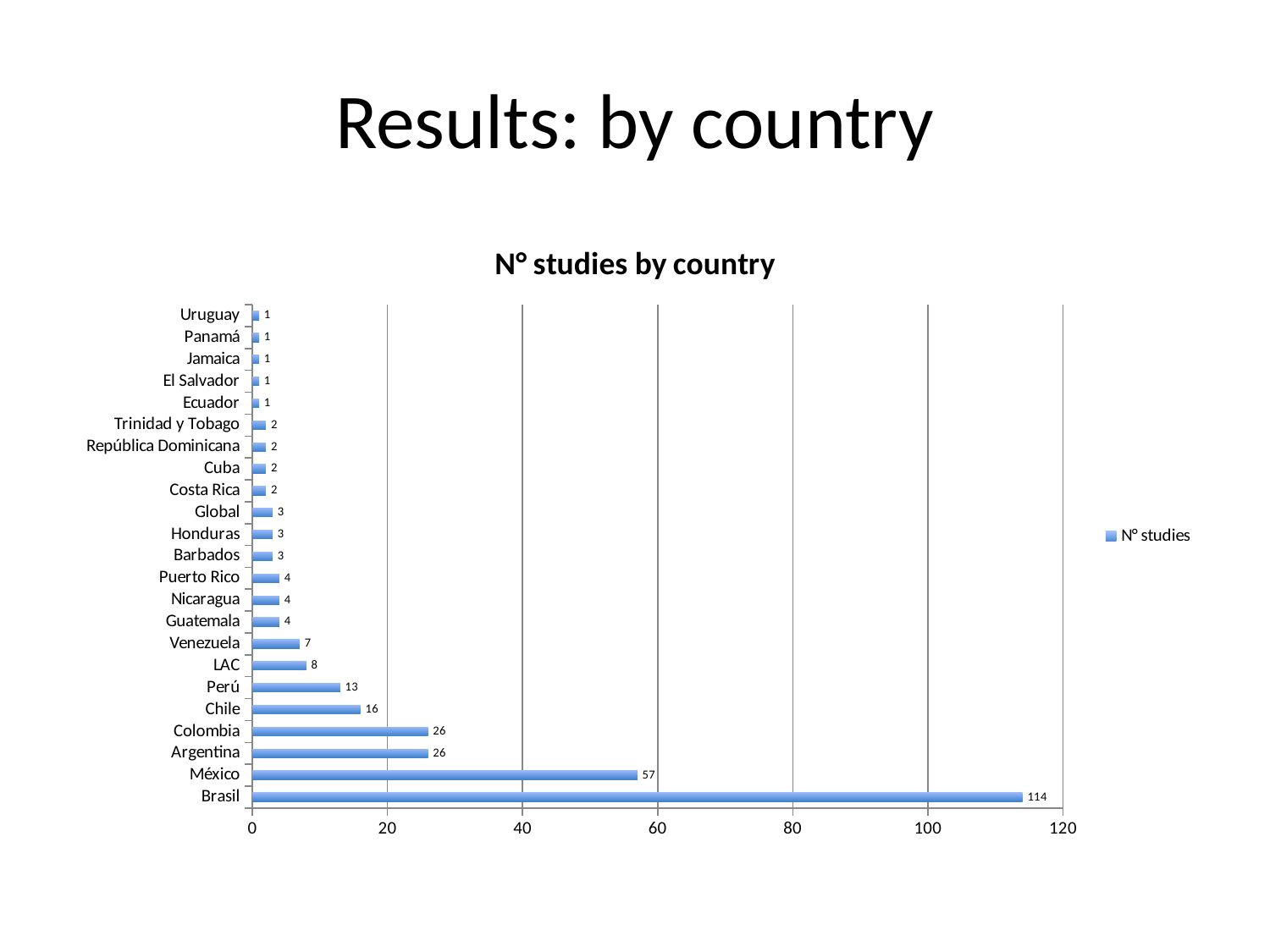
What is the difference in number of studies between Brasil and México? 57 What is the title of the chart? N° studies by country Is the value for México greater or less than 40? greater What is the number of studies for México? 57 How many categories are shown on the chart? 23 What is the number of studies for Perú? 13 What is the number of studies for Brasil? 114 What is the number of studies for Chile? 16 Which has more studies, Venezuela or LAC? LAC Which country has the highest number of studies? Brasil What is the difference in number of studies between Colombia and Chile? 10 What kind of chart is shown on the slide? Bar chart